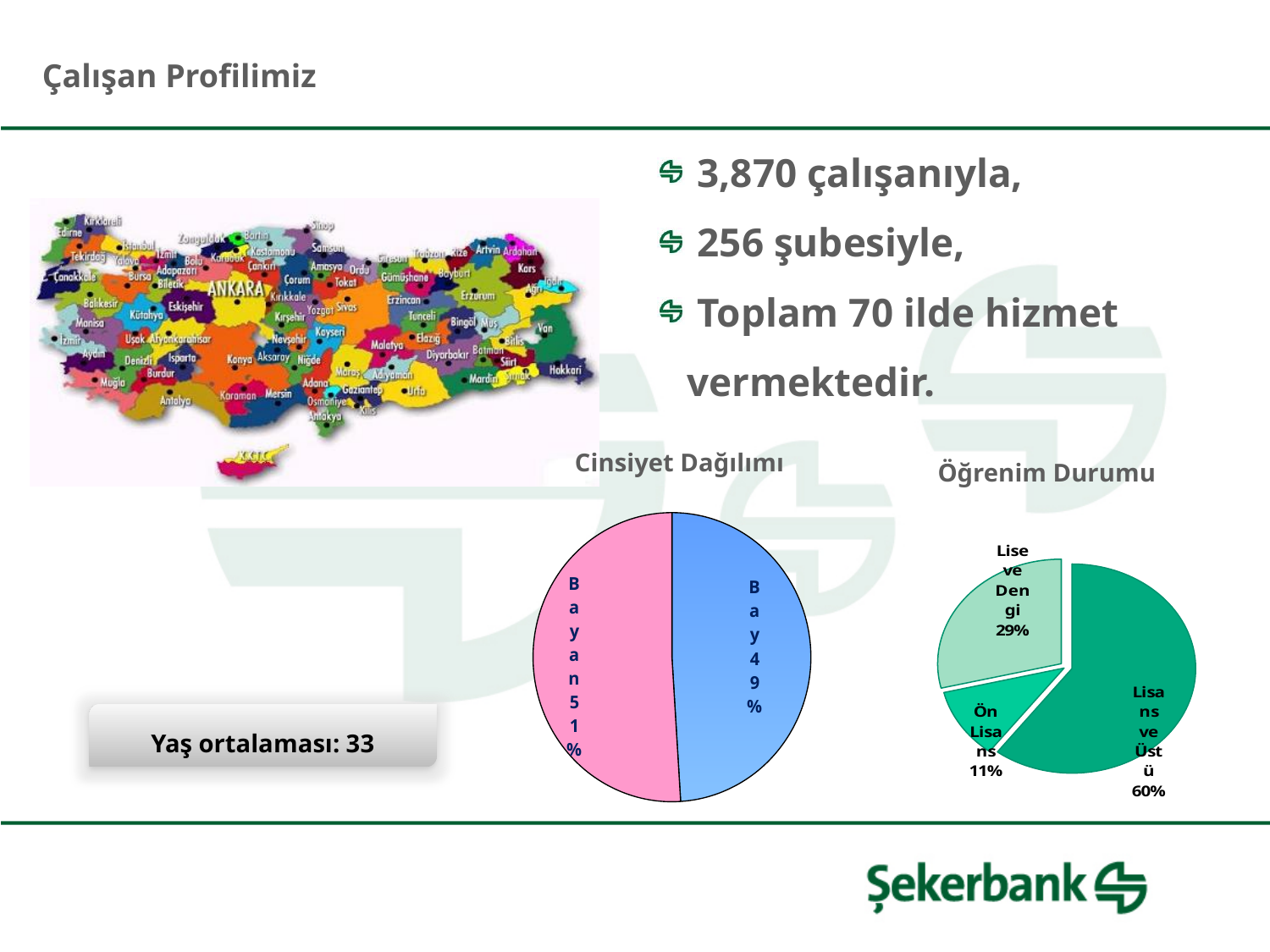
In the Cinsiyet Dağılımı chart, what is the difference between the Bayan and Bay shares? 2% In the Öğrenim Durumu chart, what share is labelled for Ön Lisans? 11% How many slices does the Cinsiyet Dağılımı pie chart have? 2 In the Öğrenim Durumu chart, what is the difference between the Lisans ve Üstü and Lise ve Dengi shares? 31% In the Cinsiyet Dağılımı chart, which slice is larger, Bayan or Bay? Bayan In the Öğrenim Durumu chart, what share is labelled for Lise ve Dengi? 29% In the Öğrenim Durumu chart, which category has the largest share? Lisans ve Üstü In the Öğrenim Durumu chart, which category has the smallest share? Ön Lisans In the Cinsiyet Dağılımı chart, what share is labelled for Bay? 49% In the Öğrenim Durumu chart, what share is labelled for Lisans ve Üstü? 60% In the Cinsiyet Dağılımı chart, what share is labelled for Bayan? 51% What kind of chart is the Cinsiyet Dağılımı chart? Pie chart